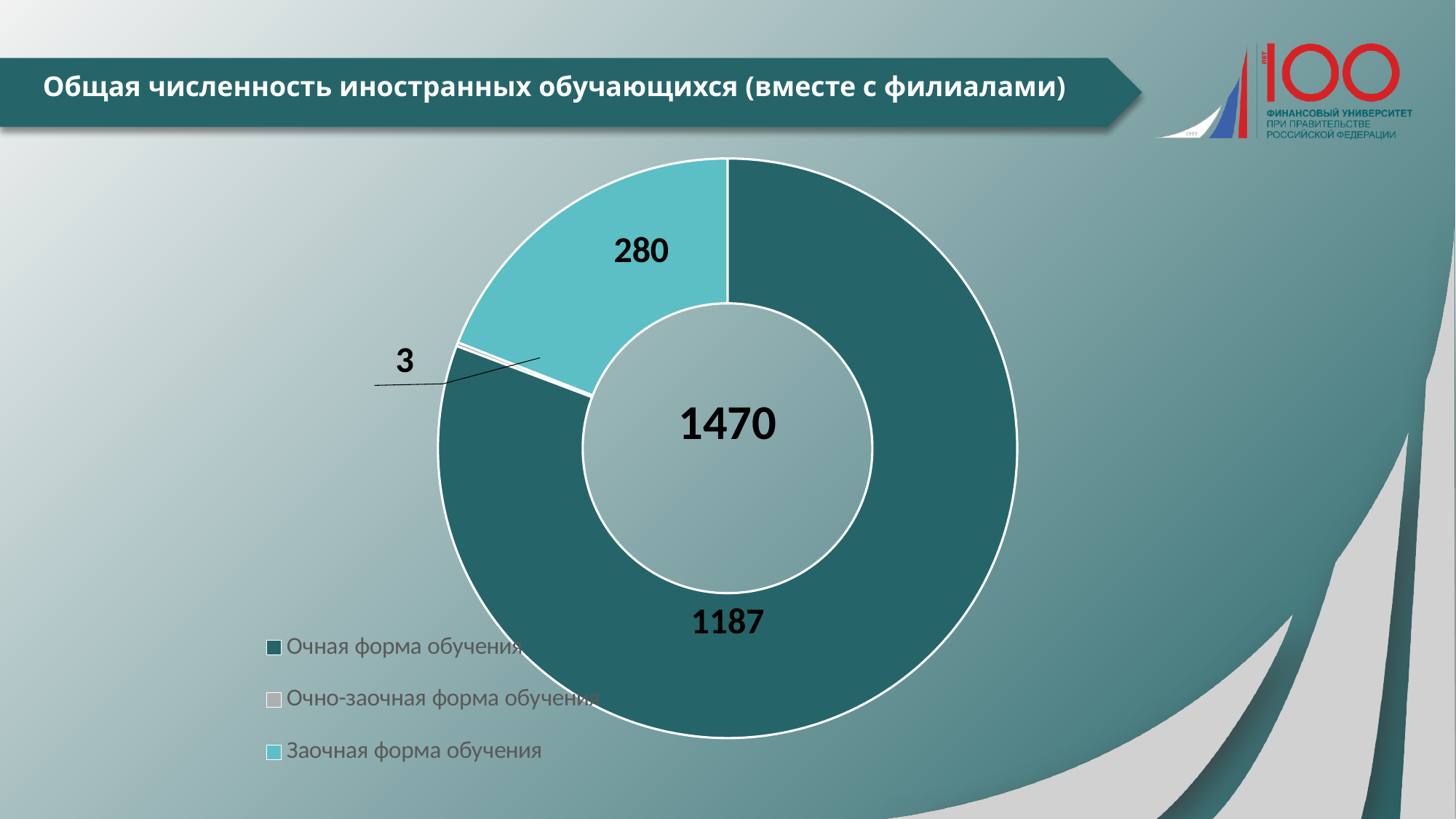
What total number is shown in the centre of the chart? 1470 What is the difference between the values for Очная форма обучения and Заочная форма обучения? 907 What is the value for Заочная форма обучения? 280 What type of chart is shown on the slide? Doughnut (pie) chart What is the title of the chart? Общая численность иностранных обучающихся (вместе с филиалами) How many categories does the chart show? 3 Which is larger: the value for Заочная форма обучения or Очно-заочная форма обучения? Заочная форма обучения What is the value for Очная форма обучения? 1187 Which category has the highest value? Очная форма обучения What is the value for Очно-заочная форма обучения? 3 What is the difference between the values for Заочная форма обучения and Очно-заочная форма обучения? 277 Which category has the lowest value? Очно-заочная форма обучения